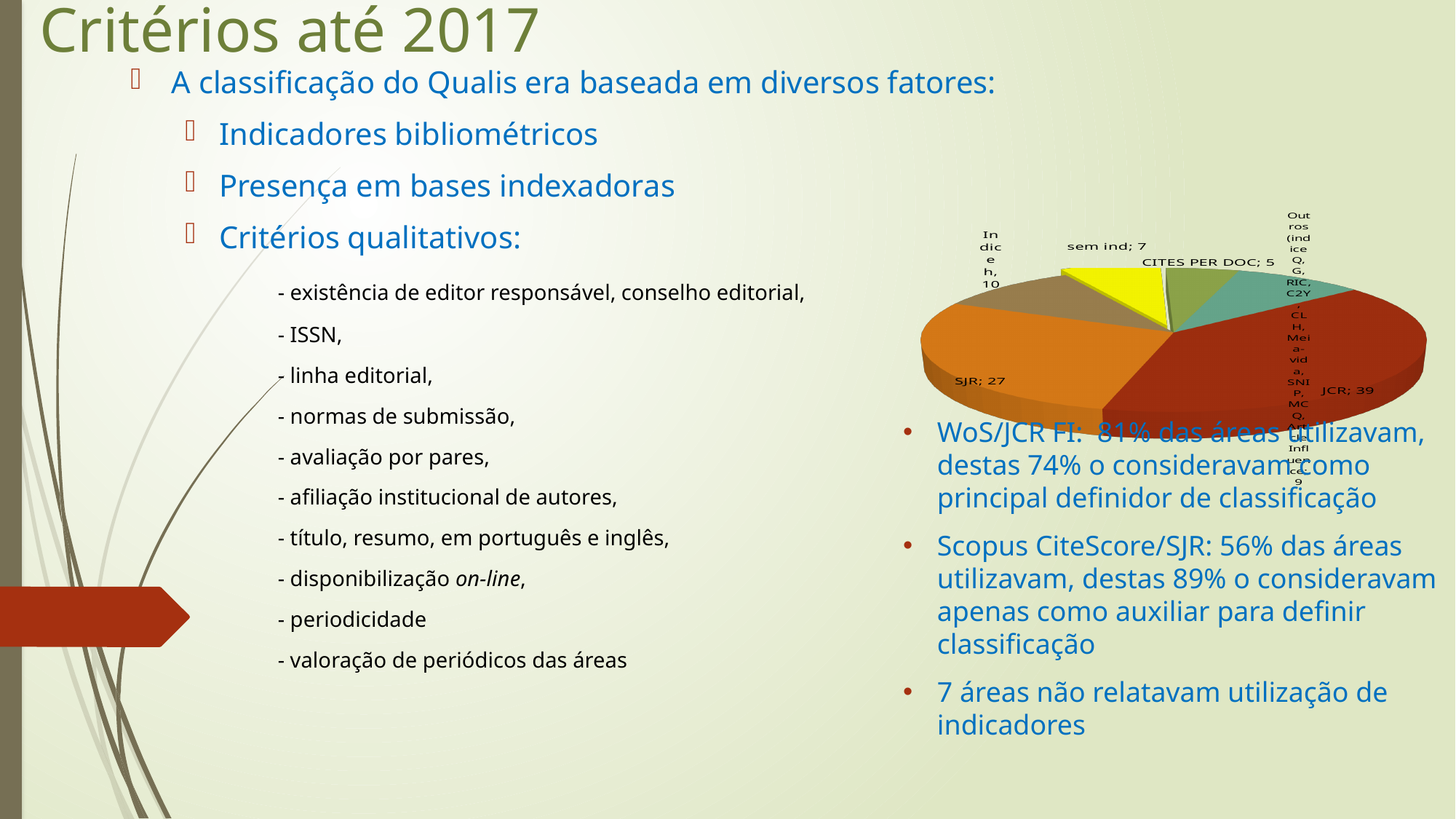
What kind of chart is shown on the slide? pie chart Which is larger in the pie chart, SJR or 'Indice h'? SJR What colour is the JCR slice in the pie chart? dark red What is the difference between the values for JCR and SJR in the pie chart? 12 What is the value for 'Indice h' in the pie chart? 10 Which slice of the pie chart has the largest value? JCR What is the value for 'sem ind' in the pie chart? 7 What is the value for SJR in the pie chart? 27 Which slice of the pie chart has the smallest value? CITES PER DOC How many slices does the pie chart have? 6 What is the value for CITES PER DOC in the pie chart? 5 What is the value for JCR in the pie chart? 39